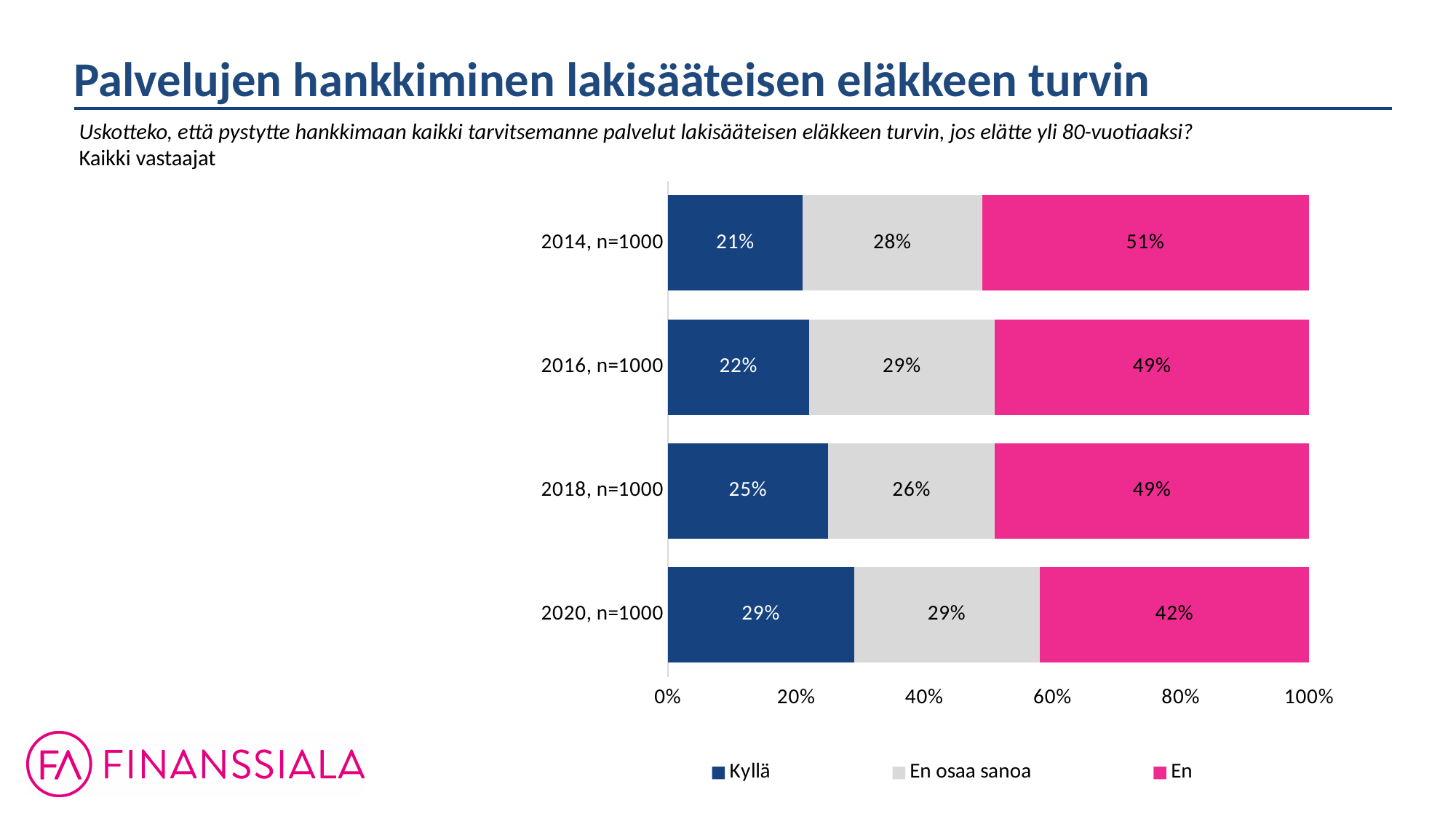
What kind of chart is shown on the slide? Stacked bar chart In which year is the "Kyllä" share the highest? 2020, n=1000 Which colour represents the "En" series in the chart? Pink How many series does the legend list? 3 What is the "En osaa sanoa" value for 2018, n=1000? 26% How many year categories are shown in the chart? 4 What is the difference between the "En" share in 2014 and in 2020? 9 percentage points Does the "Kyllä" share rise or fall from 2014 to 2020? Rise What percentage of respondents answered "En" in 2014, n=1000? 51% In which year is the "En" share the lowest? 2020, n=1000 What percentage of respondents answered "Kyllä" in 2020, n=1000? 29% Which is larger in 2016, n=1000: the "Kyllä" share or the "En osaa sanoa" share? En osaa sanoa